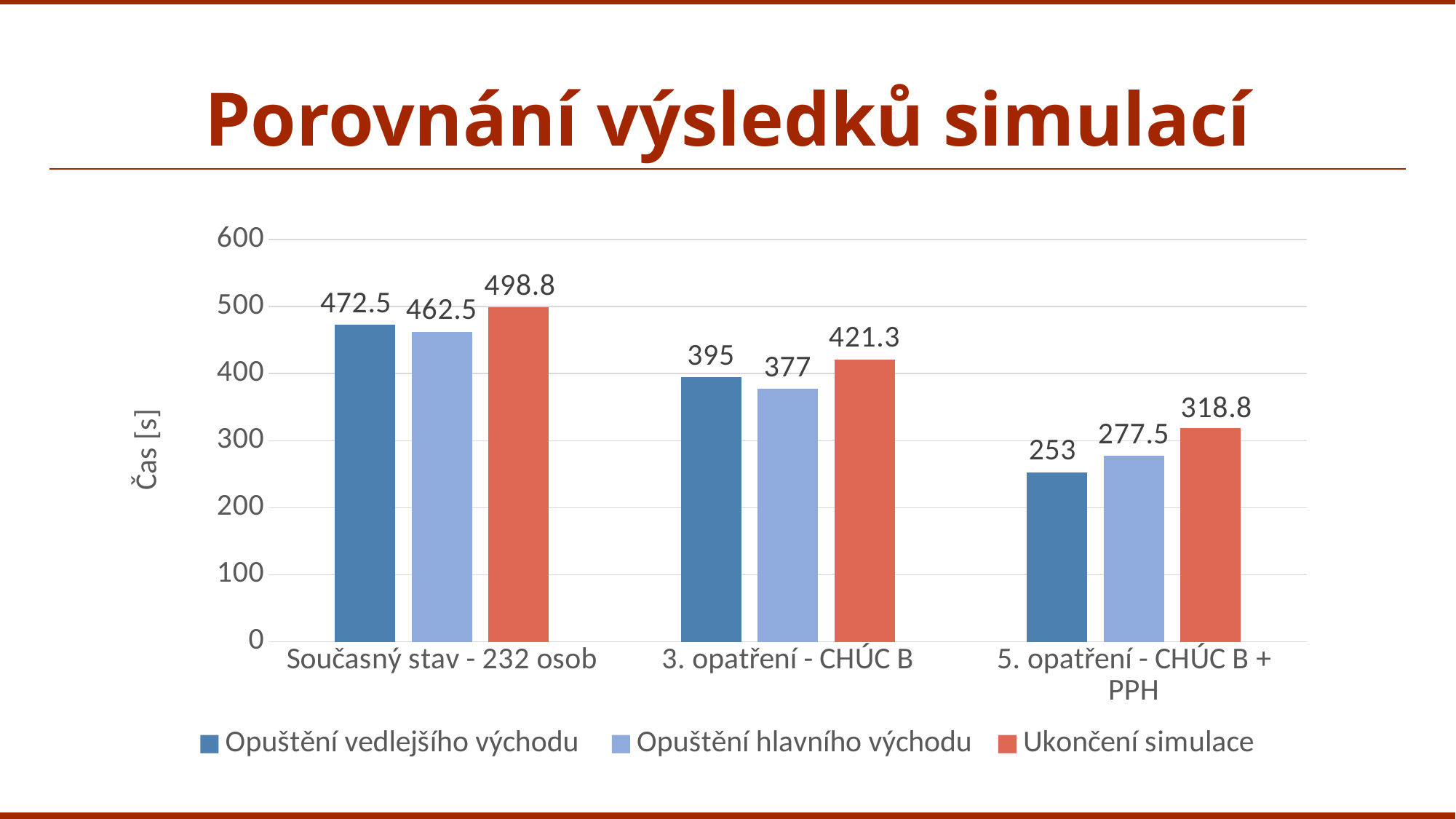
What kind of chart is shown on the slide? bar chart How many categories are shown on the x axis? 3 What is the value of Ukončení simulace for Současný stav - 232 osob? 498.8 Is the value of Ukončení simulace for 5. opatření - CHÚC B + PPH greater or less than 300? greater What is the value of Opuštění vedlejšího východu for 5. opatření - CHÚC B + PPH? 253 What is the value of Opuštění hlavního východu for 3. opatření - CHÚC B? 377 What is the difference between Ukončení simulace and Opuštění vedlejšího východu for 3. opatření - CHÚC B? 26.3 How many series does the legend list? 3 What is the label of the y axis? Čas [s] Which category has the highest value for Ukončení simulace? Současný stav - 232 osob Which is larger for Současný stav - 232 osob: Opuštění vedlejšího východu or Opuštění hlavního východu? Opuštění vedlejšího východu Which category has the lowest value for Opuštění vedlejšího východu? 5. opatření - CHÚC B + PPH